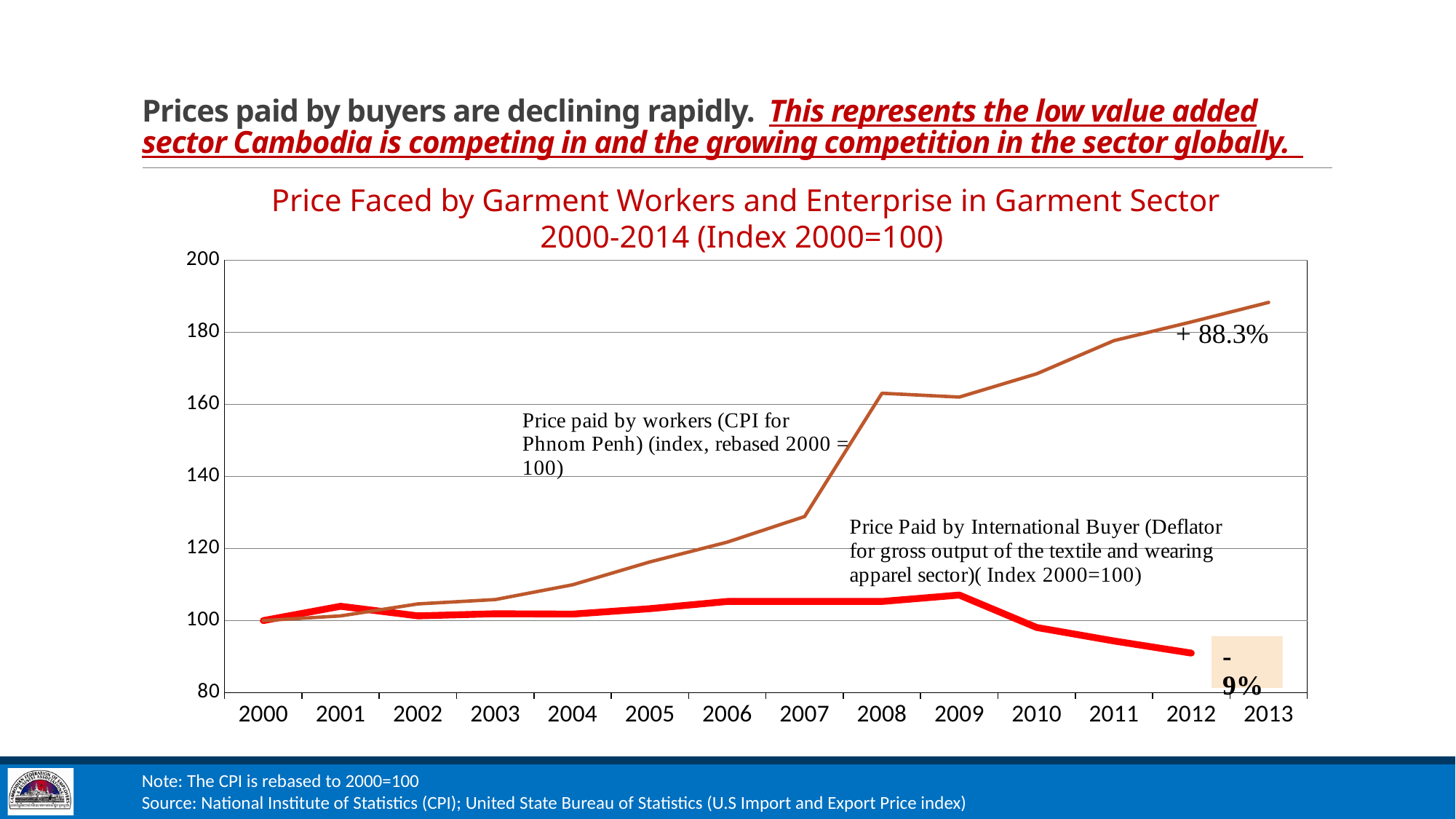
Is the value for Price Paid by International Buyer in 2012 greater or less than 100? less What percentage change is annotated next to the end of the Price paid by workers line? + 88.3% What is the title of the chart? Price Faced by Garment Workers and Enterprise in Garment Sector 2000-2014 (Index 2000=100) What is the lowest value shown on the y axis of the chart? 80 Is the value for Price paid by workers in 2013 greater or less than 180? greater Does the line for Price paid by workers (CPI for Phnom Penh) rise or fall from 2000 to 2013? rise What percentage change is annotated next to the end of the Price Paid by International Buyer line? - 9% How many years are labelled along the x axis of the chart? 14 In 2011, which series has the higher value: Price paid by workers or Price Paid by International Buyer? Price paid by workers Is the value for Price paid by workers in 2008 greater or less than 160? greater Does the line for Price Paid by International Buyer rise or fall from 2009 to 2012? fall What kind of chart is shown on the slide? line chart